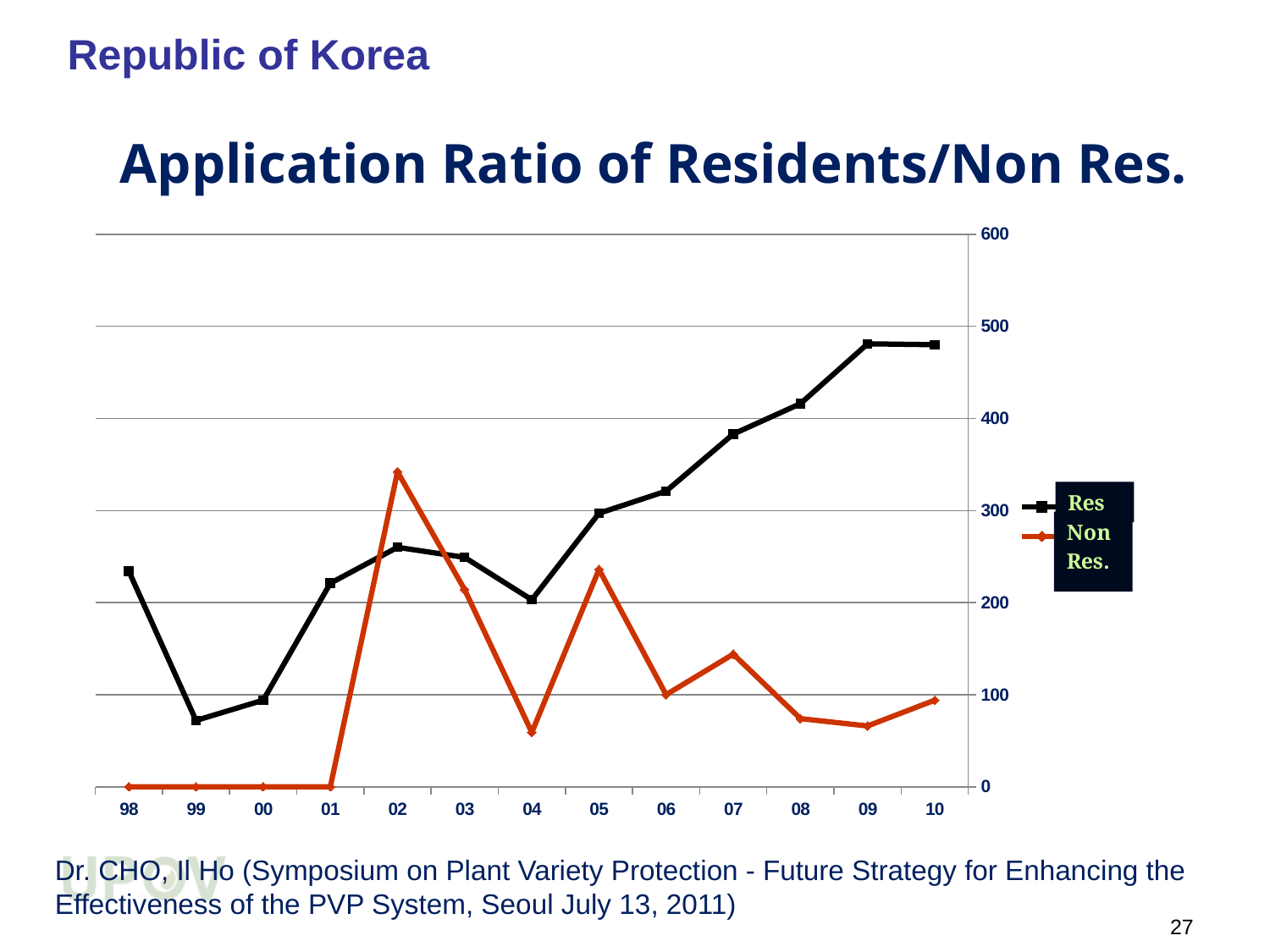
Is the Non Res value for 04 greater or less than 100? less In which year is the Non Res series at its highest? 02 What is the Non Res value in 01? 0 What is the Non Res value in 98? 0 What is the title of the chart? Application Ratio of Residents/Non Res. Does the Res series rise or fall from 04 to 09? rise What kind of chart is shown on the slide? line chart How many series does the legend list? 2 In which year is the Res series at its lowest? 99 In 02, which series has the higher value, Res or Non Res? Non Res Is the Res value for 09 greater or less than 400? greater How many years are plotted along the x axis? 13